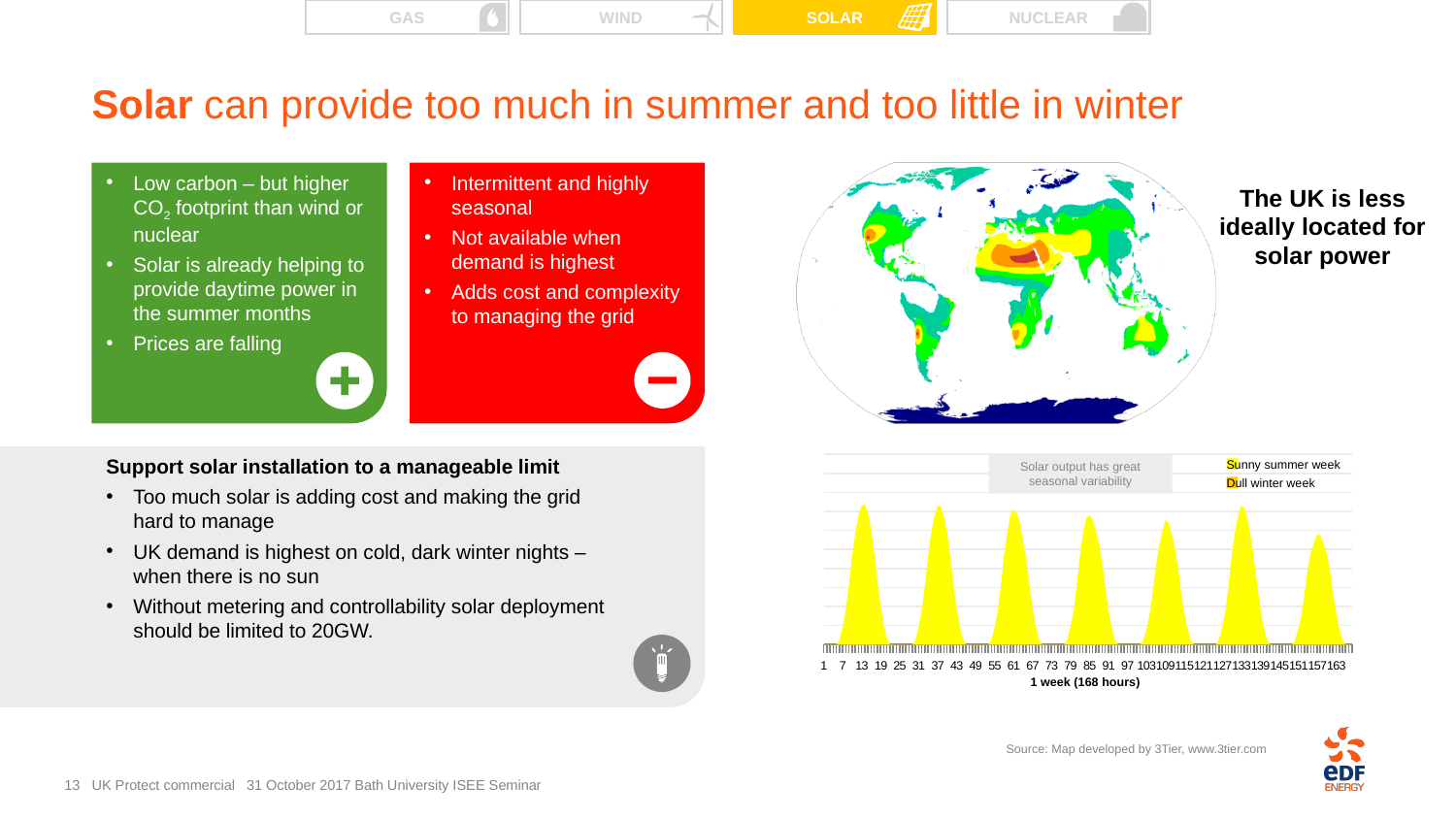
How many daily peaks are plotted in the solar output chart? 7 In the solar output chart, which series shows higher output: Sunny summer week or Dull winter week? Sunny summer week What is the first tick label on the x axis of the solar output chart? 1 How many series does the legend of the solar output chart list? 2 What kind of chart is shown at the bottom right of the slide? Area chart What is the last tick label on the x axis of the solar output chart? 163 What is the x-axis title of the solar output chart? 1 week (168 hours) What are the two series named in the legend of the solar output chart? Sunny summer week and Dull winter week